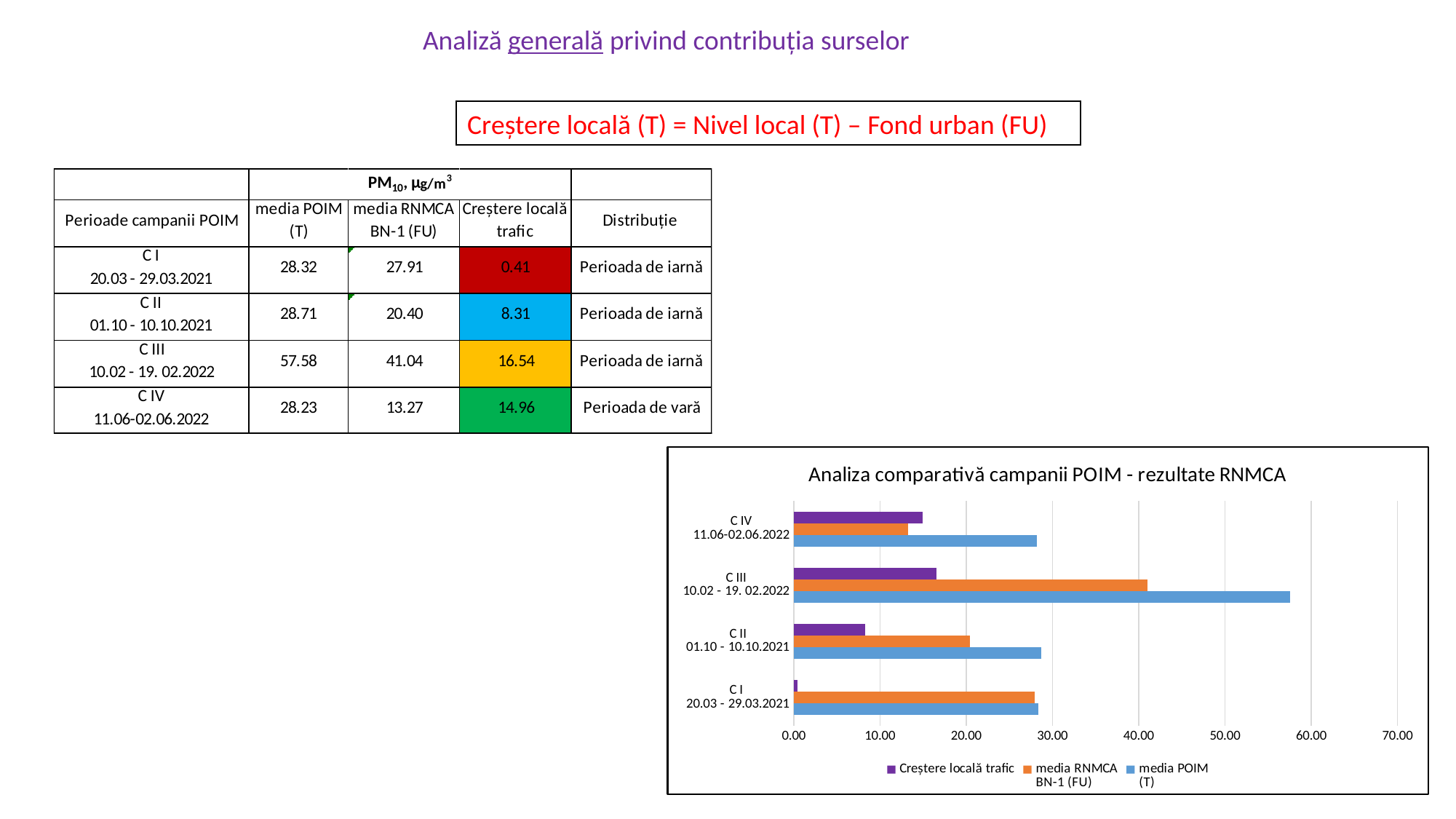
Which campaign has the highest value for media POIM (T) in the chart? C III 10.02 - 19. 02.2022 How many campaign categories are plotted on the chart? 4 Is the value for media RNMCA BN-1 (FU) for C IV greater or less than 20.00? less How many series does the legend of the chart list? 3 For C II, which is larger: media POIM (T) or media RNMCA BN-1 (FU)? media POIM (T) What kind of chart is shown on the slide? bar chart What is the value of media POIM (T) for C III, as printed in the table on the slide? 57.58 What is the title of the chart? Analiza comparativă campanii POIM - rezultate RNMCA Which campaign has the lowest value for Creștere locală trafic in the chart? C I 20.03 - 29.03.2021 What is the difference between media POIM (T) and media RNMCA BN-1 (FU) for C III? 16.54 Is the value for media POIM (T) for C III greater or less than 50.00? greater What colour represents the Creștere locală trafic series in the chart? purple